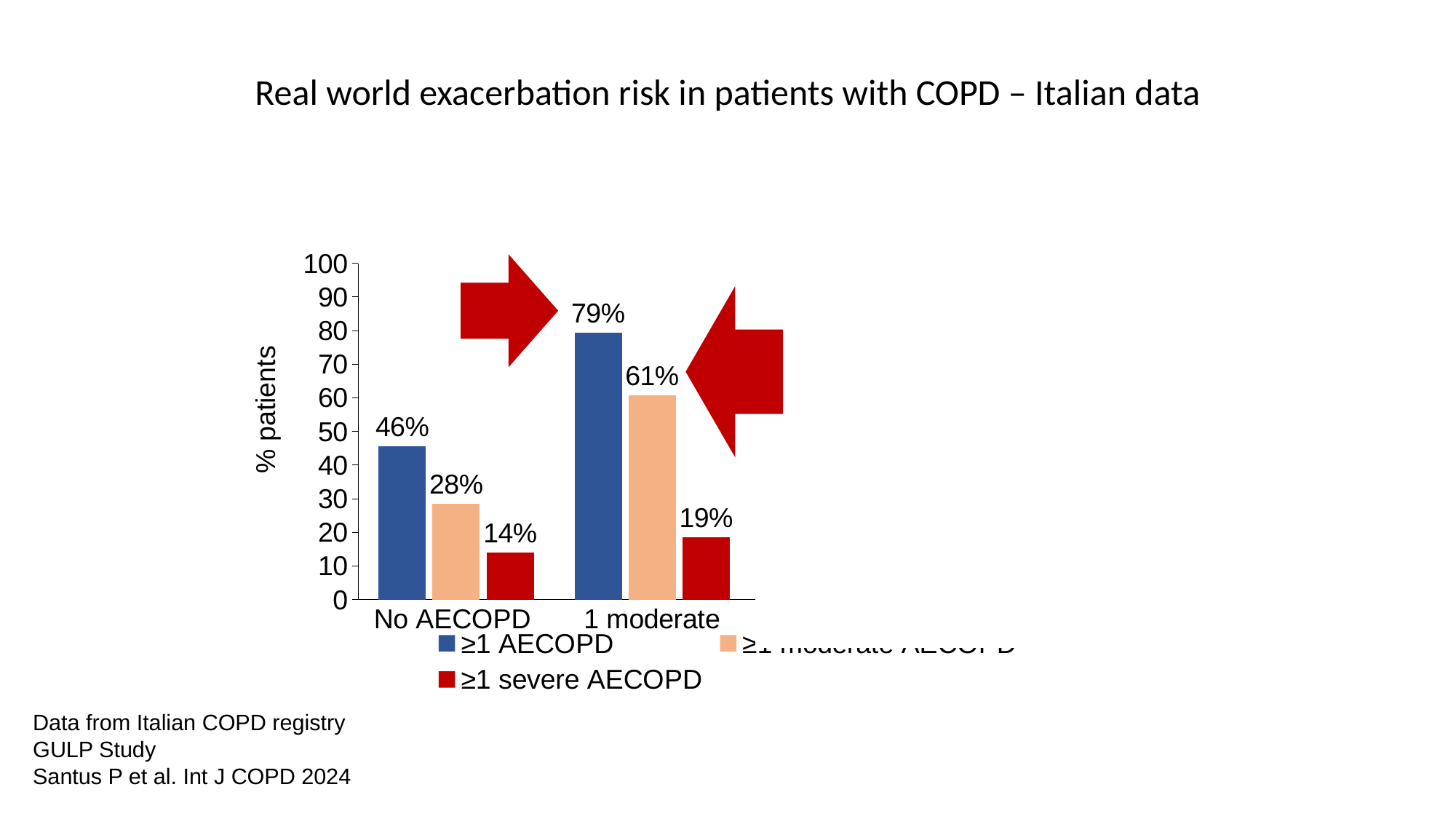
What is the label of the y axis? % patients Which is larger: the ≥1 moderate AECOPD value for No AECOPD or for 1 moderate? 1 moderate What is the value for ≥1 severe AECOPD in the No AECOPD category? 14% How many series does the legend list? 3 Which series has the highest value in the 1 moderate category? ≥1 AECOPD What is the value for ≥1 moderate AECOPD in the 1 moderate category? 61% What is the value for ≥1 AECOPD in the No AECOPD category? 46% What is the difference between the ≥1 AECOPD values for the 1 moderate and No AECOPD categories? 33% What is the value for ≥1 severe AECOPD in the 1 moderate category? 19% What kind of chart is shown on the slide? Bar chart How many categories are shown on the x axis? 2 Which series has the lowest value in the No AECOPD category? ≥1 severe AECOPD